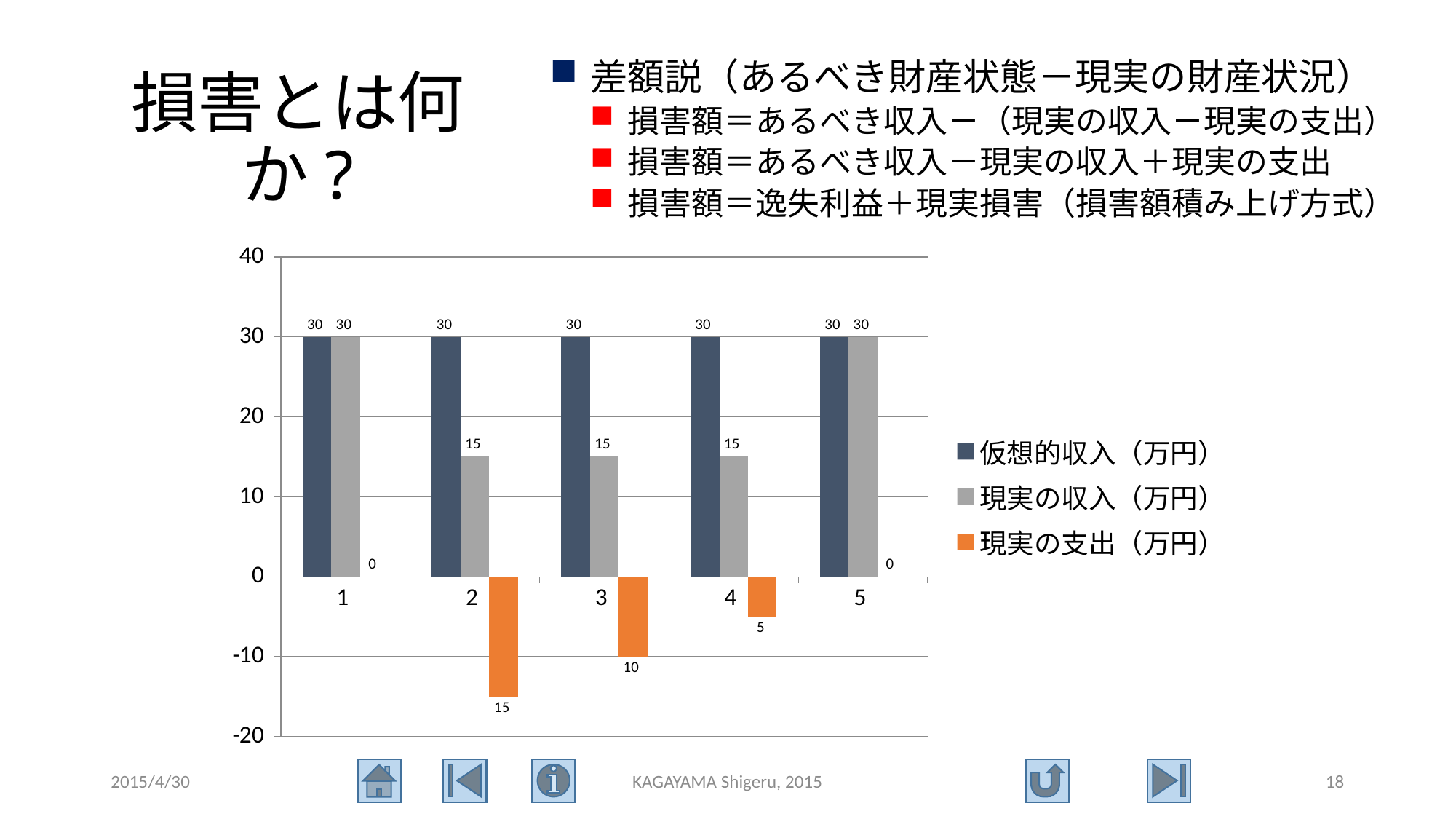
How many categories are shown on the x axis of the chart? 5 Which is larger for category 2: 仮想的収入（万円） or 現実の収入（万円）? 仮想的収入（万円） What is the value of 現実の収入（万円） for category 5? 30 What kind of chart is shown on the slide? bar chart Which series is shown in orange in the chart legend? 現実の支出（万円） Is the 現実の支出（万円） bar for category 2 plotted above or below 0 on the axis? below What is the difference between 仮想的収入（万円） and 現実の収入（万円） for category 4? 15 How many series does the chart legend list? 3 What is the data label shown for 現実の支出（万円） at category 1? 0 What is the value of 仮想的収入（万円） for category 3? 30 Does the value of 仮想的収入（万円） change across categories 1 to 5? No, it stays at 30 What is the value of 現実の収入（万円） for category 2? 15